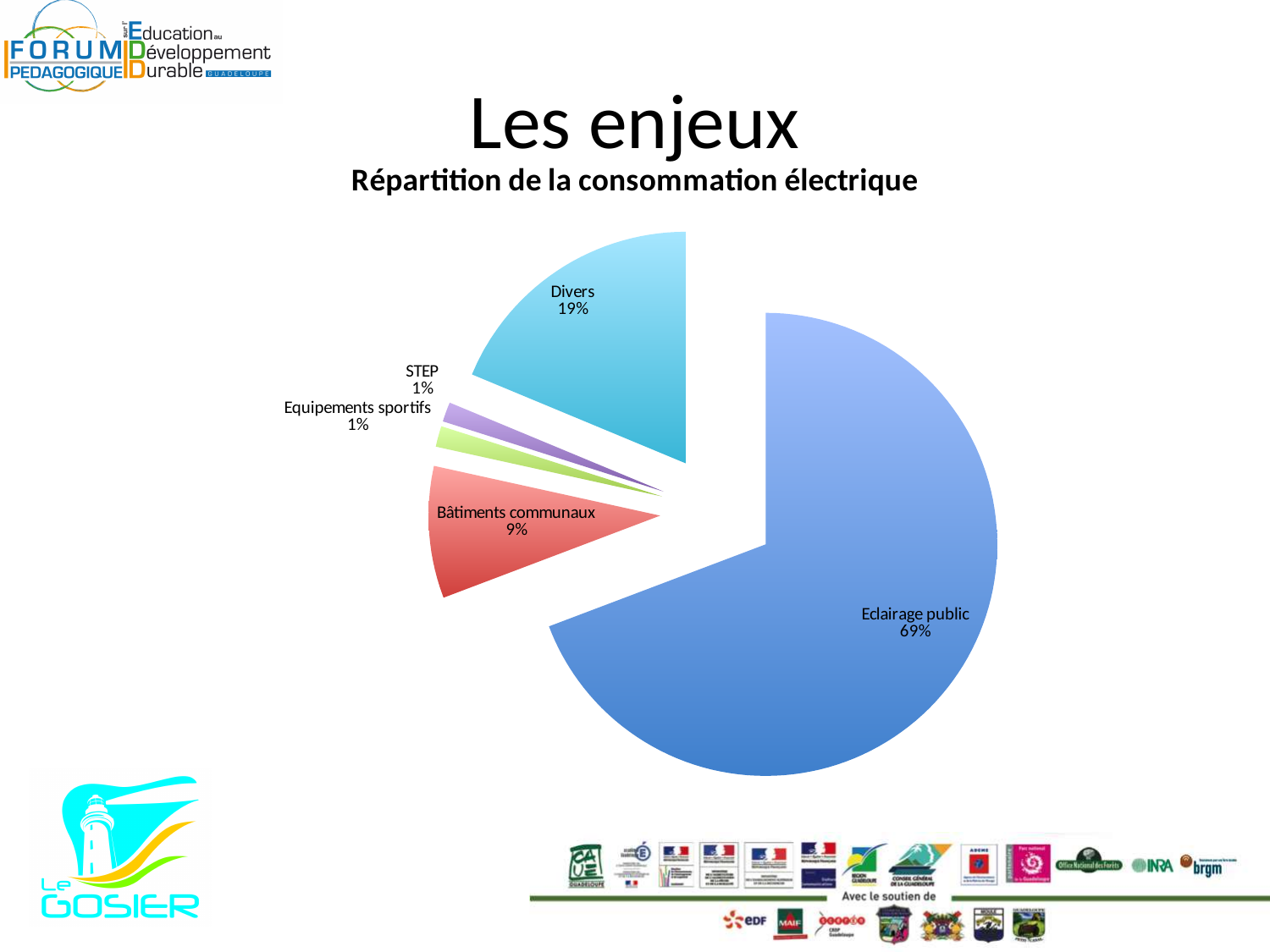
What is the title of the chart? Répartition de la consommation électrique What percentage is shown for Divers? 19% What share of electricity consumption does Eclairage public account for? 69% Which is larger, the share for Divers or the share for Bâtiments communaux? Divers What is the difference in percentage points between Divers and Bâtiments communaux? 10 Which category has the largest share of the pie? Eclairage public What is the difference in percentage points between Eclairage public and Divers? 50 What percentage is shown for Bâtiments communaux? 9% How many categories are shown in the pie chart? 5 What percentage is shown for STEP? 1% What colour is the Eclairage public slice? Blue What kind of chart is shown on the slide? Pie chart